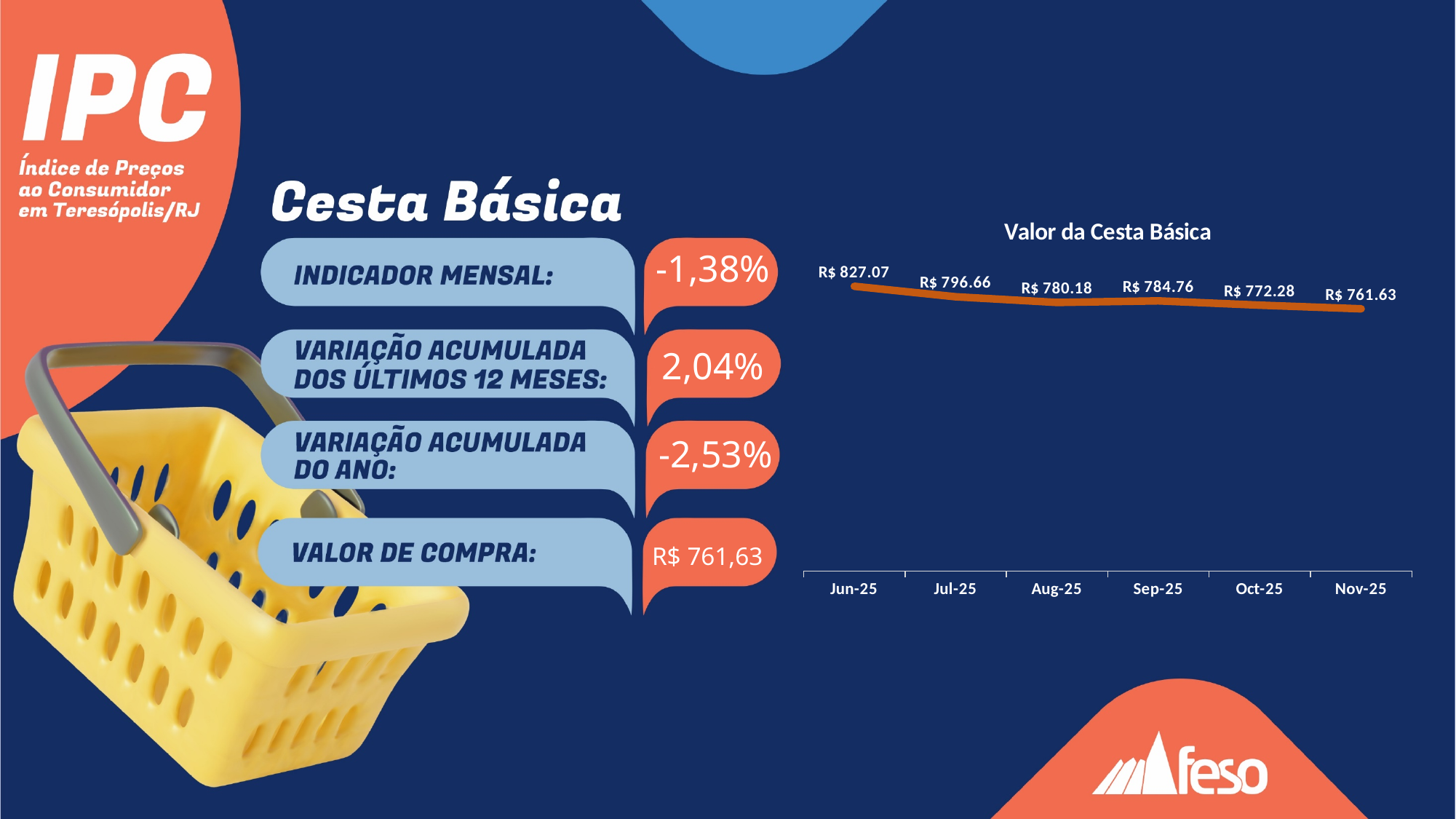
How many months are plotted in the Valor da Cesta Básica chart? 6 Which month has the lowest value in the Valor da Cesta Básica chart? Nov-25 Which is larger in the Valor da Cesta Básica chart, the value for Aug-25 or Sep-25? Sep-25 What is the value for Sep-25 in the Valor da Cesta Básica chart? R$ 784.76 What is the difference between the Jul-25 and Aug-25 values in the Valor da Cesta Básica chart? R$ 16.48 Which month has the highest value in the Valor da Cesta Básica chart? Jun-25 What is the value for Oct-25 in the Valor da Cesta Básica chart? R$ 772.28 What is the difference between the Jun-25 and Nov-25 values in the Valor da Cesta Básica chart? R$ 65.44 What is the value for Jun-25 in the Valor da Cesta Básica chart? R$ 827.07 Do the values in the Valor da Cesta Básica chart generally rise or fall from Jun-25 to Nov-25? Fall What kind of chart is the Valor da Cesta Básica chart? Line chart What is the value for Nov-25 in the Valor da Cesta Básica chart? R$ 761.63